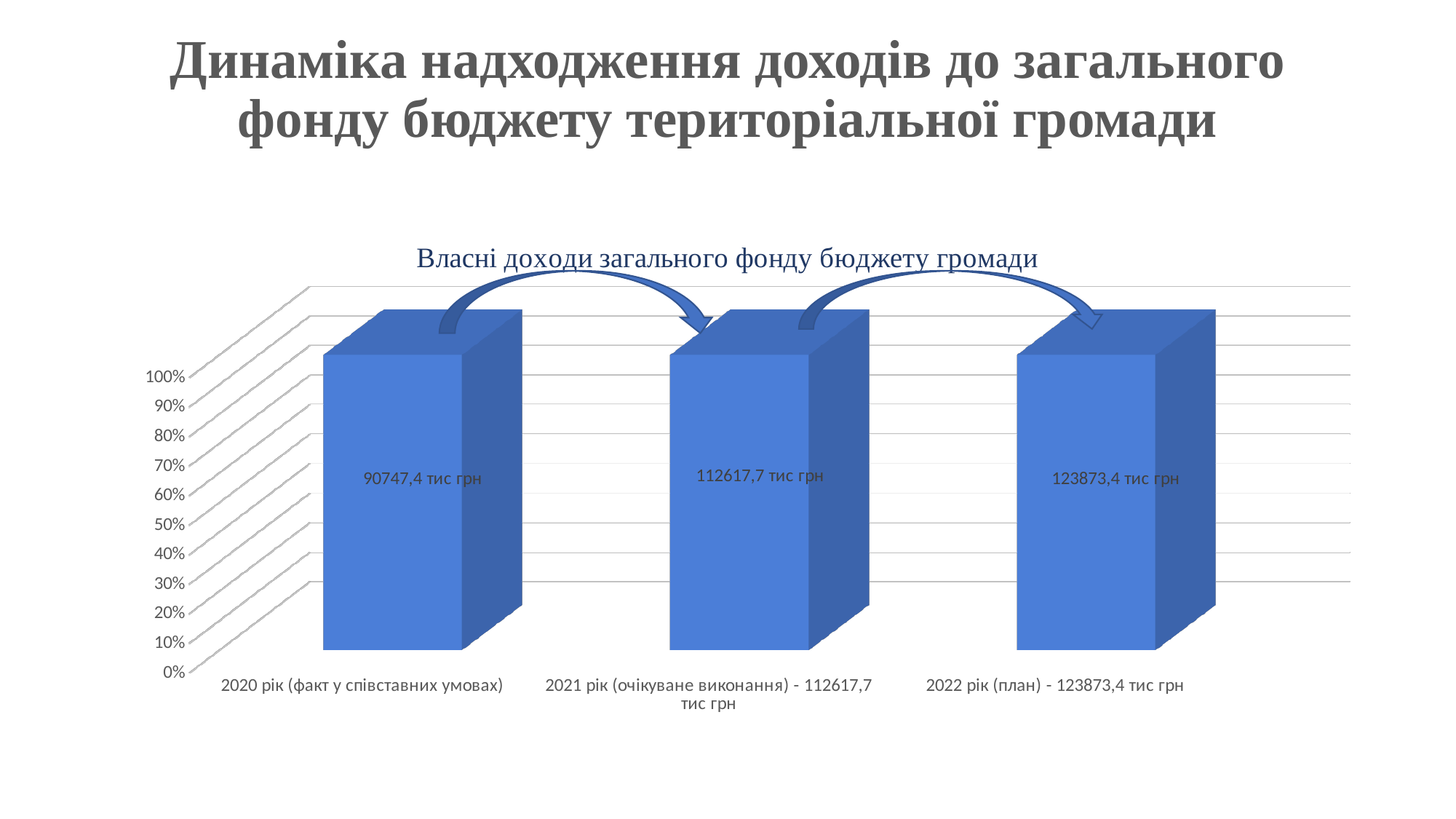
By how much does the labelled value for 2021 рік exceed the labelled value for 2020 рік? 21870,3 тис грн By how much does the labelled value for 2022 рік exceed the labelled value for 2021 рік? 11255,7 тис грн What is the data label on the bar for 2021 рік (очікуване виконання)? 112617,7 тис грн Which labelled value is larger: 2020 рік or 2022 рік? 2022 рік How many bars are shown in the chart? 3 What is the data label on the bar for 2022 рік (план)? 123873,4 тис грн Do the labelled values rise or fall from 2020 to 2022? Rise According to the data labels, which year has the lowest value? 2020 рік (факт у співставних умовах) What is the title of the chart? Власні доходи загального фонду бюджету громади According to the data labels, which year has the highest value? 2022 рік (план) What kind of chart is shown on the slide? Bar chart What is the data label on the bar for 2020 рік (факт у співставних умовах)? 90747,4 тис грн